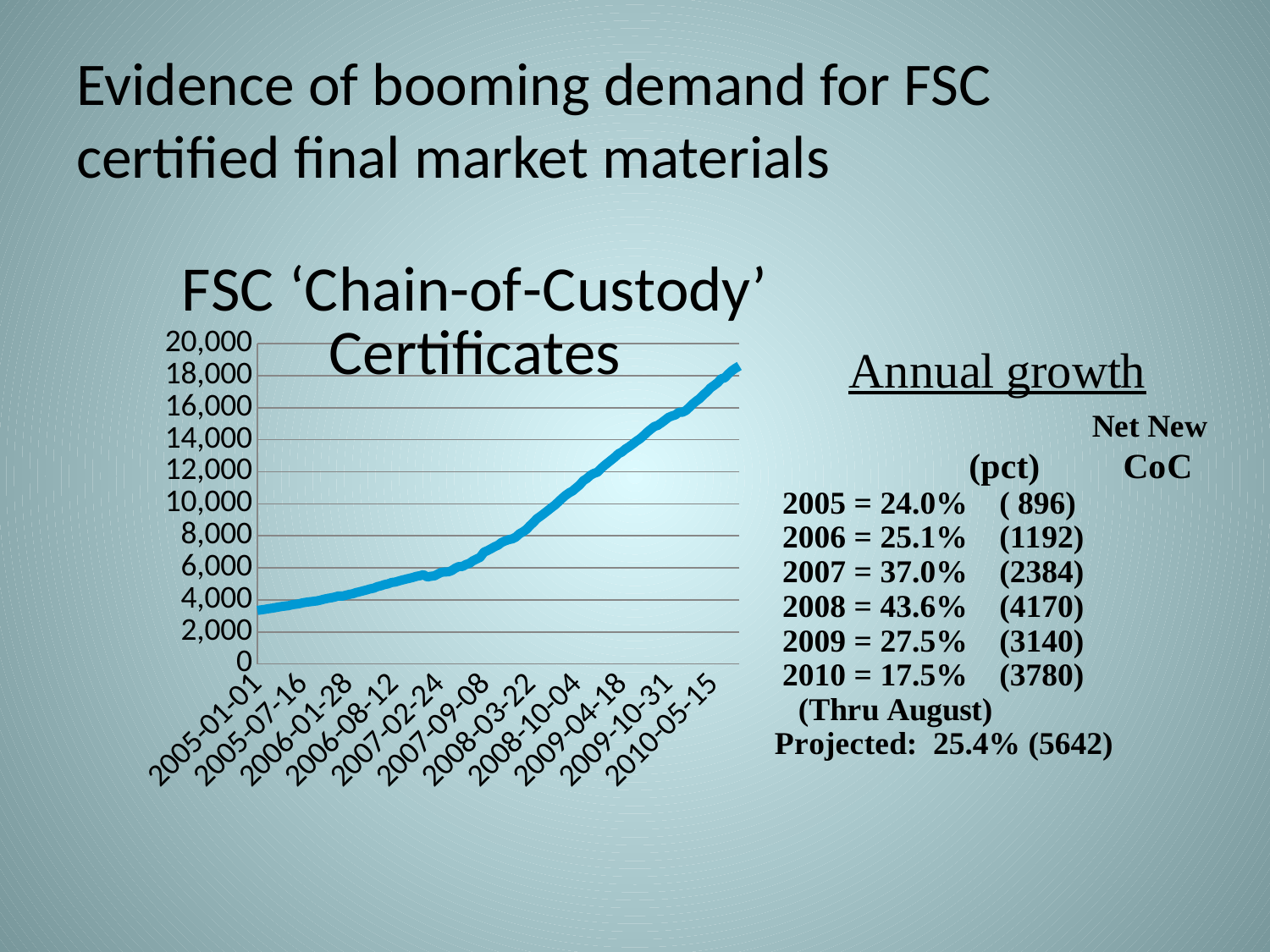
At which x-axis date is the line at its lowest value? 2005-01-01 Do the values in the chart rise or fall from left to right along the x axis? rise Which has the larger value, 2009-10-31 or 2006-01-28? 2009-10-31 What kind of chart is shown on the slide? line chart Is the value at 2010-05-15 greater or less than 16,000? greater Is the value at 2005-01-01 greater or less than 2,000? greater What is the title of the chart? FSC 'Chain-of-Custody' Certificates Is the value at 2009-04-18 greater or less than 12,000? greater How many date labels are shown on the x axis of the chart? 11 At which x-axis date does the line reach its highest value? 2010-05-15